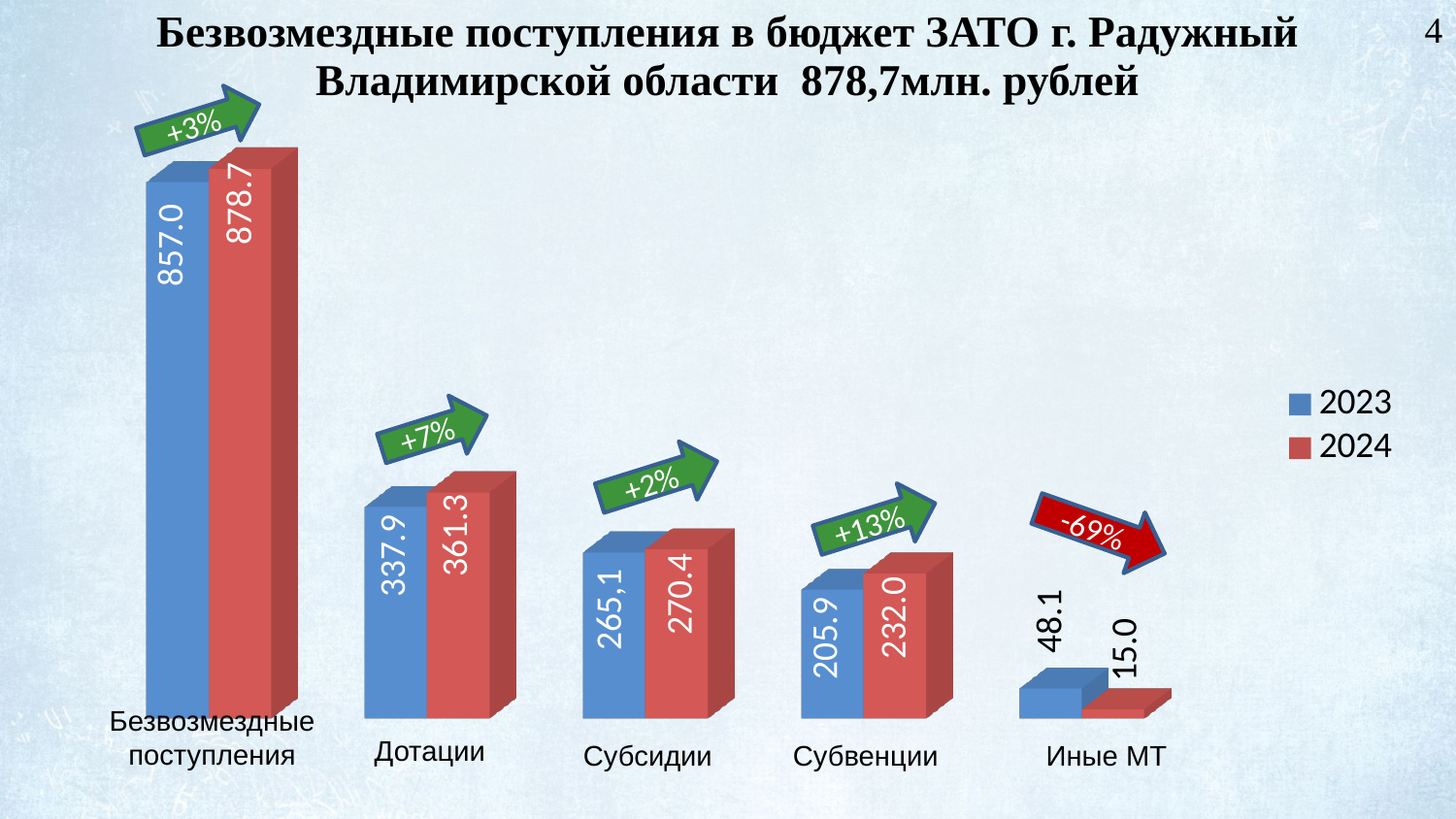
Which category has the lowest 2023 value? Иные МТ What is the 2023 value for Субсидии? 265,1 What is the difference between the 2023 and 2024 values for Иные МТ? 33.1 What is the 2024 value for Иные МТ? 15.0 For Дотации, which is larger: the 2023 value or the 2024 value? 2024 How many categories are shown on the x axis? 5 How many series does the legend list? 2 What percentage change is shown by the arrow above Субвенции? +13% What is the difference between the 2024 and 2023 values for Субвенции? 26.1 What is the 2023 value for Субвенции? 205.9 What is the 2024 value for Дотации? 361.3 Which category has the highest 2024 value? Безвозмездные поступления